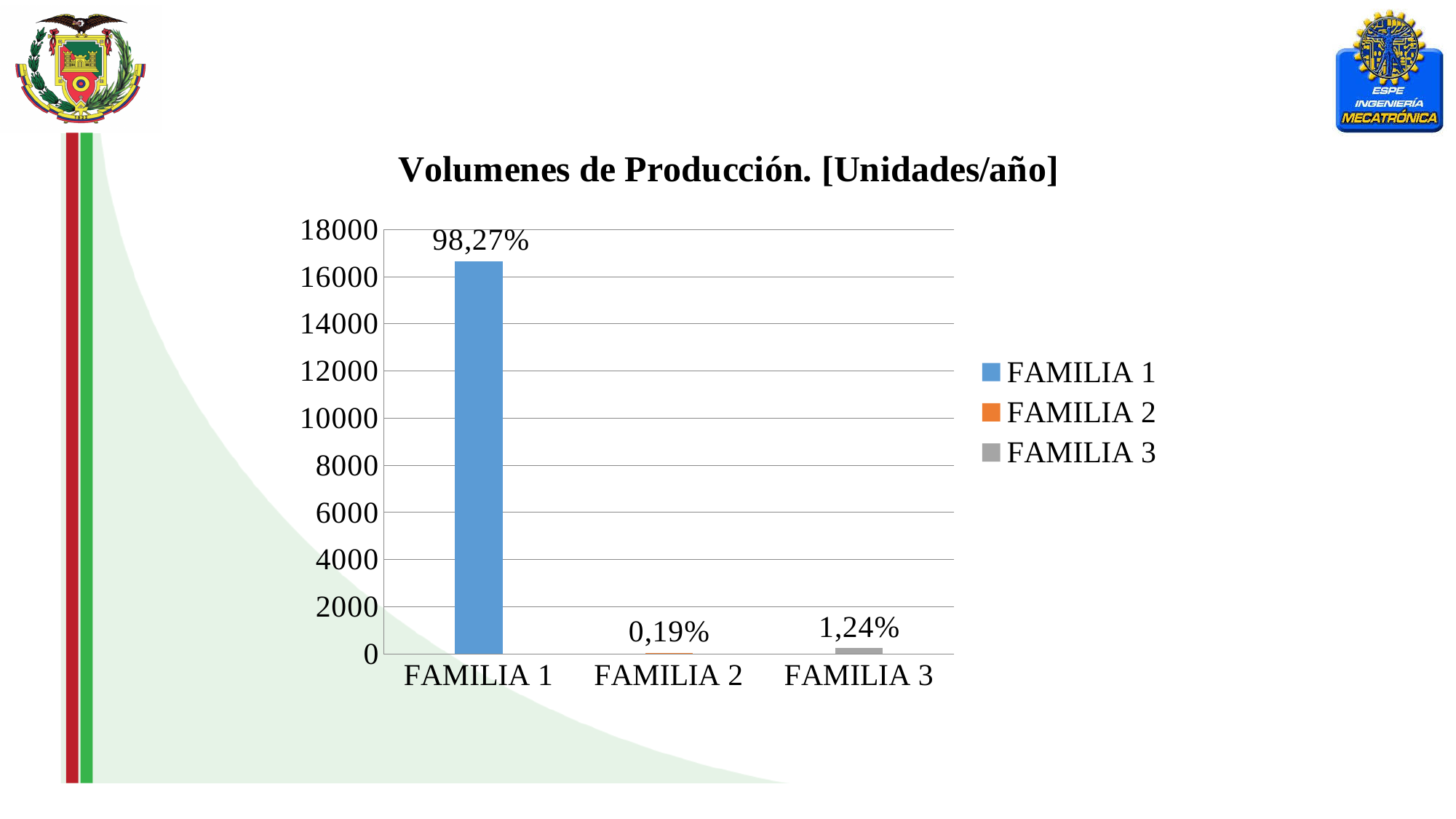
Which category has the highest production volume? FAMILIA 1 How many categories are shown on the x axis? 3 Is the value for FAMILIA 1 greater or less than 14000? greater What is the data label shown for FAMILIA 2? 0,19% What is the title of the chart? Volumenes de Producción. [Unidades/año] Which category has the lowest production volume? FAMILIA 2 How many entries does the legend list? 3 What is the data label shown for FAMILIA 3? 1,24% What is the difference between the percentage labels of FAMILIA 3 and FAMILIA 2? 1,05% Is the value for FAMILIA 3 greater or less than 2000? less Which is larger, the value for FAMILIA 3 or the value for FAMILIA 2? FAMILIA 3 What is the data label shown on the FAMILIA 1 bar? 98,27%